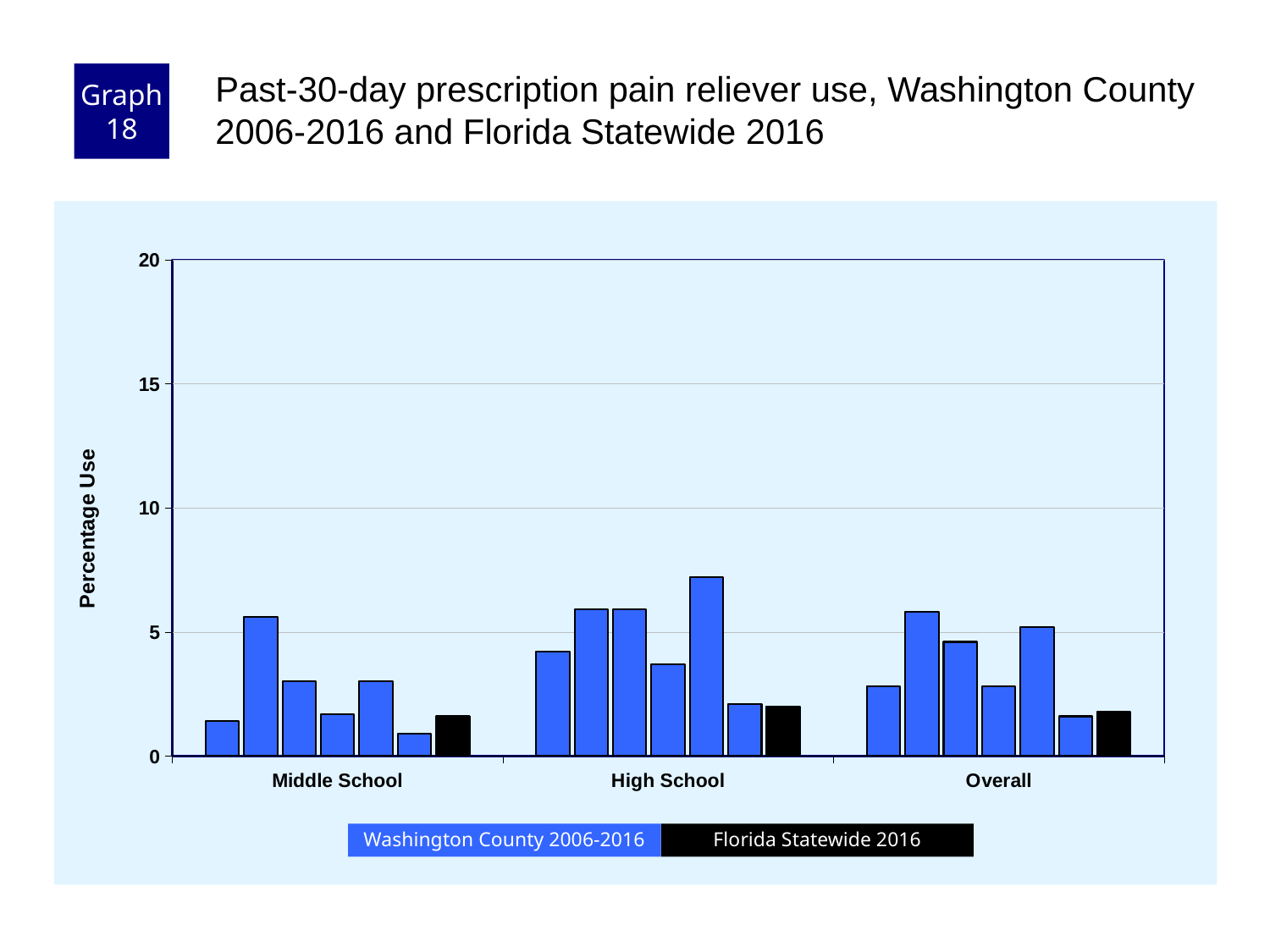
Which is larger: the tallest Washington County 2006-2016 bar in the High School group or the Florida Statewide 2016 bar in the High School group? The tallest Washington County 2006-2016 bar Is the tallest Washington County 2006-2016 bar in the High School group greater or less than 5? greater Is the tallest Washington County 2006-2016 bar in the Overall group greater or less than 5? greater How many series does the legend list? 2 Is the Florida Statewide 2016 value for Middle School greater or less than 5? less What is the label of the y axis? Percentage Use What kind of chart is shown on the slide? Bar chart Which group contains the tallest bar on the chart: Middle School, High School, or Overall? High School How many categories are shown on the x axis? 3 Which colour represents Florida Statewide 2016 in the legend? Black